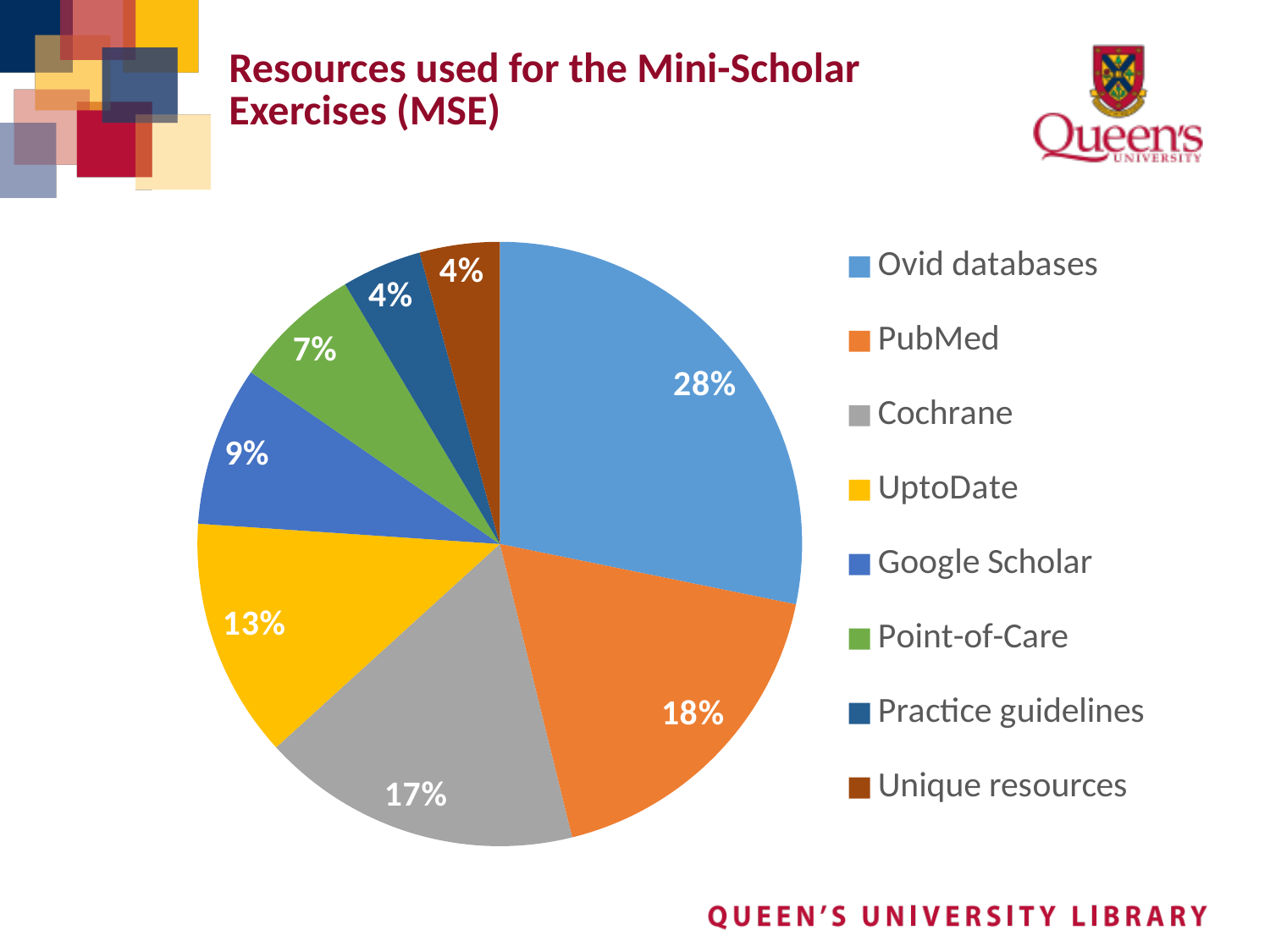
How many resource categories are shown in the pie chart? 8 What is the difference in percentage points between Ovid databases and PubMed? 10 Which has a larger share, UptoDate or Google Scholar? UptoDate What percentage is shown for UptoDate? 13% Which resource has the largest share of the pie? Ovid databases What is the title of the chart on the slide? Resources used for the Mini-Scholar Exercises (MSE) What percentage is shown for PubMed? 18% What percentage is shown for Google Scholar? 9% What percentage is shown for Point-of-Care? 7% What share of the pie does Ovid databases account for? 28% What percentage is shown for Cochrane? 17% What type of chart is shown on the slide? Pie chart